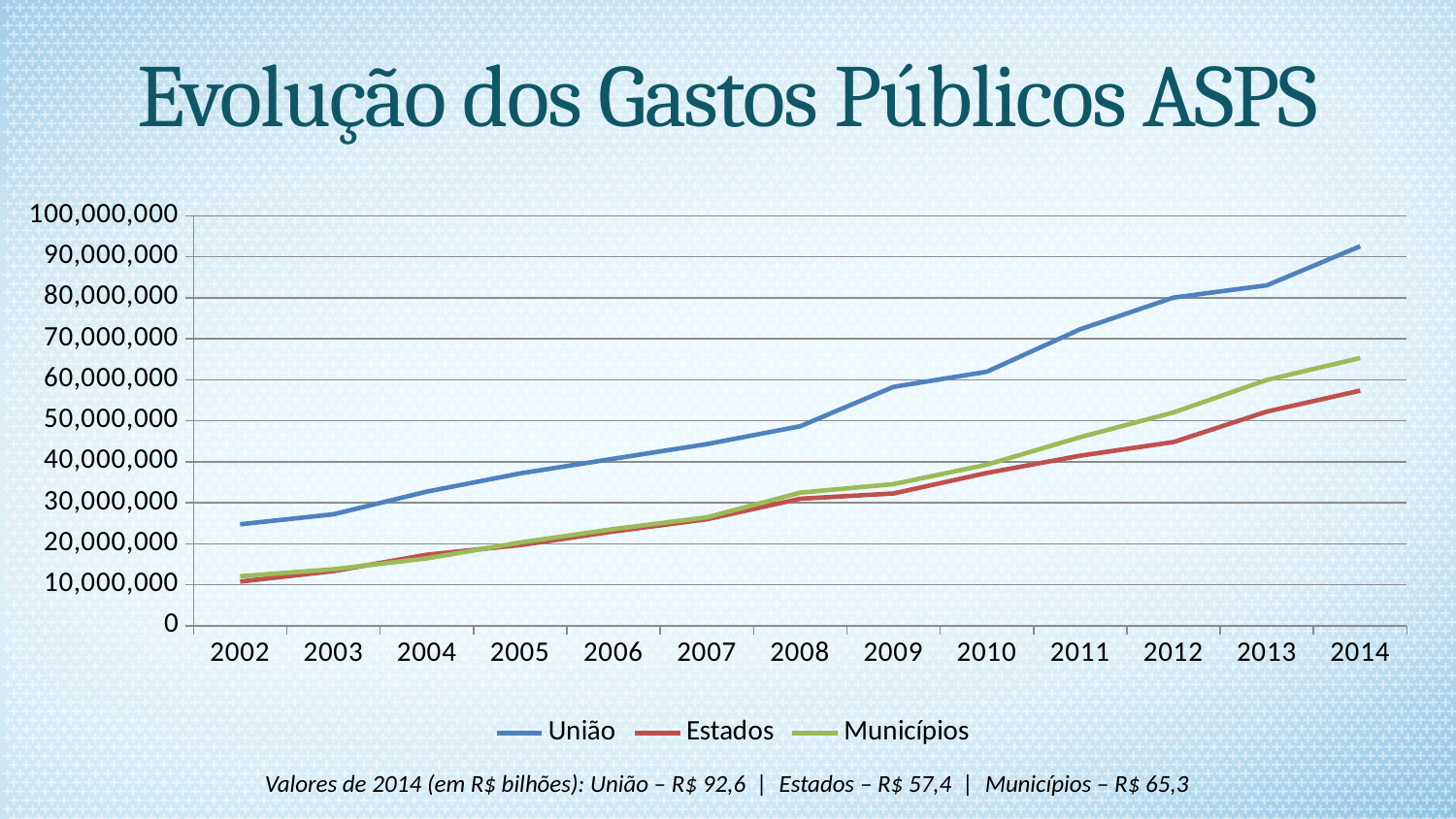
In 2014, which is larger: Municípios or Estados? Municípios According to the note below the chart, what is the difference between the 2014 values for União (R$ 92,6) and Estados (R$ 57,4) in R$ bilhões? R$ 35,2 How many series does the legend list? 3 Which series has the highest value in 2014? União What kind of chart is shown on the slide? line chart Is the value for Estados in 2014 greater or less than 60,000,000? less According to the note below the chart, what is the 2014 value for Municípios in R$ bilhões? R$ 65,3 Does the União series rise or fall from 2002 to 2014? rise How many years are shown on the x axis? 13 Is the value for União in 2014 greater or less than 90,000,000? greater Which series has the lowest value in 2014? Estados